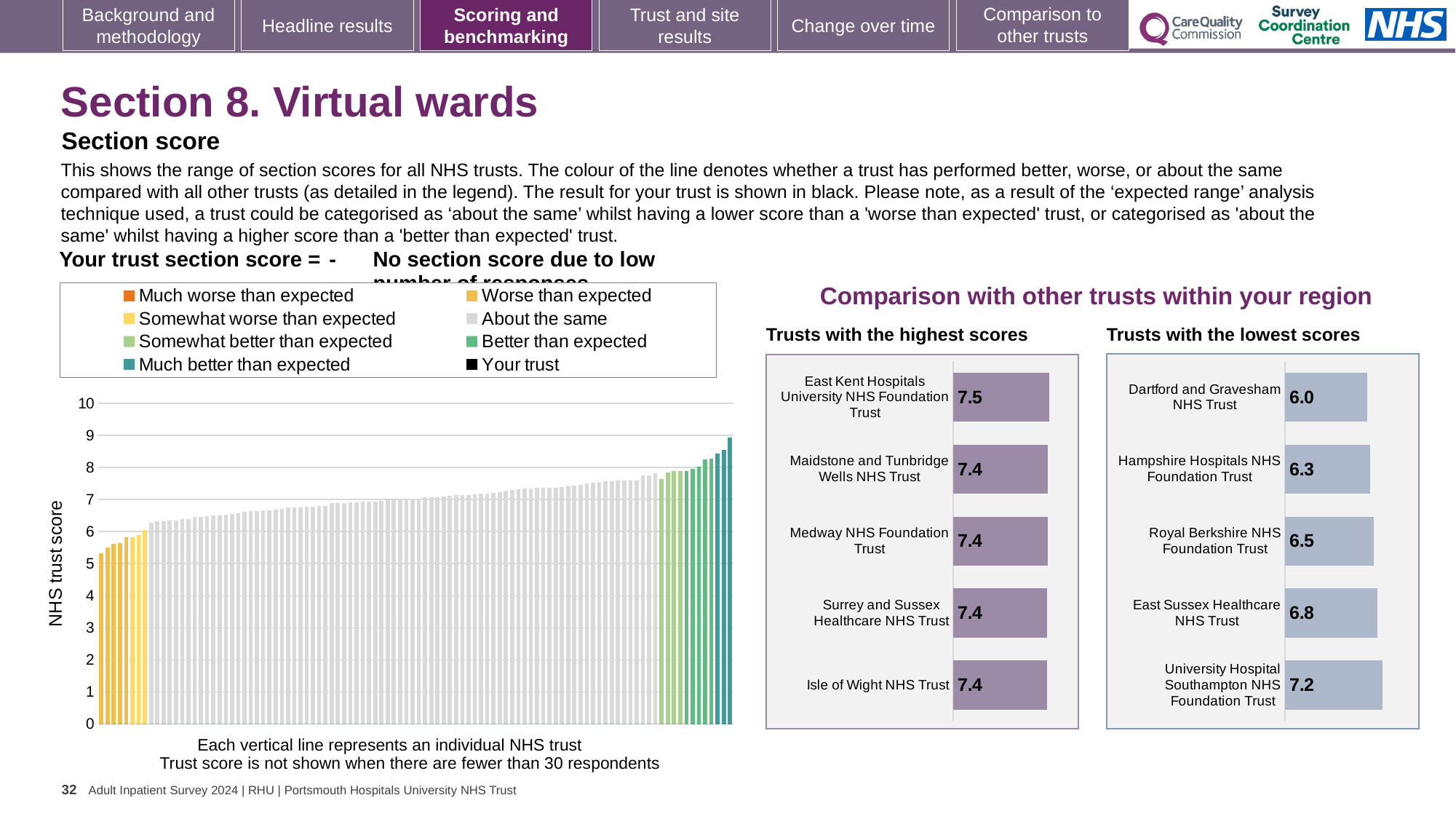
In the large chart on the left showing NHS trust scores, do the values rise or fall from left to right? Rise In the 'Trusts with the lowest scores' chart, what is the difference between the scores of University Hospital Southampton NHS Foundation Trust and Dartford and Gravesham NHS Trust? 1.2 In the 'Trusts with the lowest scores' chart, which trust has the highest score? University Hospital Southampton NHS Foundation Trust In the 'Trusts with the highest scores' chart, what is the score for East Kent Hospitals University NHS Foundation Trust? 7.5 In the 'Trusts with the lowest scores' chart, which has the larger score: Hampshire Hospitals NHS Foundation Trust or Royal Berkshire NHS Foundation Trust? Royal Berkshire NHS Foundation Trust In the 'Trusts with the highest scores' chart, how many trusts are shown? 5 In the 'Trusts with the lowest scores' chart, what is the score for Dartford and Gravesham NHS Trust? 6.0 In the 'Trusts with the lowest scores' chart, which trust has the lowest score? Dartford and Gravesham NHS Trust In the 'Trusts with the highest scores' chart, which trust has the highest score? East Kent Hospitals University NHS Foundation Trust What kind of chart is the large chart on the left showing NHS trust scores? Bar chart In the large chart on the left showing NHS trust scores, is the value of the tallest bar greater or less than 8? greater In the 'Trusts with the highest scores' chart, what is the difference between the scores of East Kent Hospitals University NHS Foundation Trust and Maidstone and Tunbridge Wells NHS Trust? 0.1